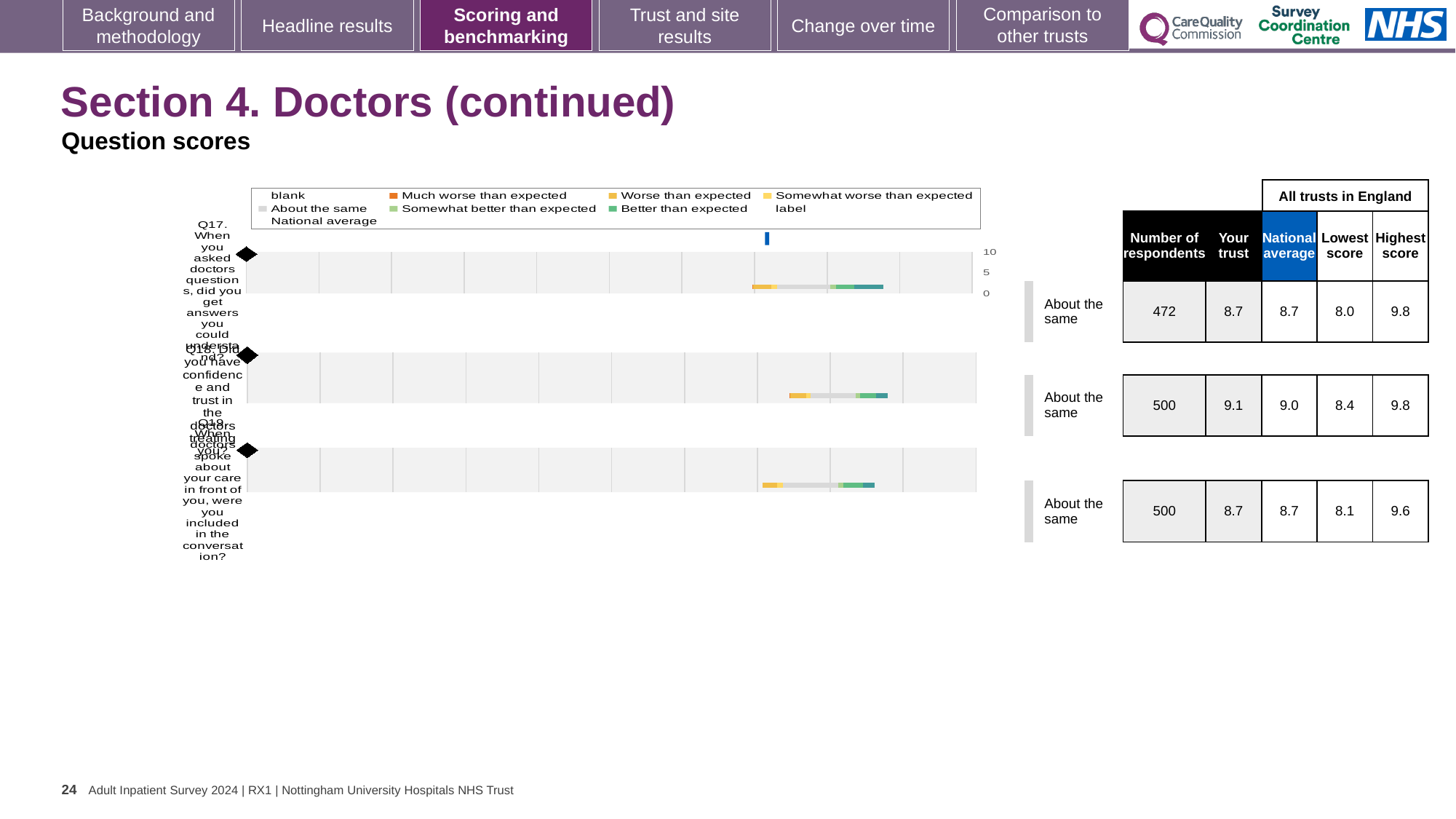
How many entries does the chart legend list? 9 According to the table beside the chart, which question has the highest 'Your trust' score? Q18 According to the table beside the chart, is the 'Your trust' score for Q18 larger or smaller than the national average for Q18? larger What kind of chart is shown on the slide? bar chart How many questions (categories) are plotted in the chart? 3 According to the table beside the chart, what is the difference between the highest score and lowest score for Q19? 1.5 According to the table beside the chart, what is the national average for Q17? 8.7 What is the highest value shown on the chart's axis? 10 According to the table beside the chart, what is the 'Your trust' score for Q18? 9.1 According to the table beside the chart, how many respondents answered Q17? 472 What benchmark category is shown next to the chart for Q17? About the same According to the table beside the chart, what is the lowest score across all trusts in England for Q17? 8.0